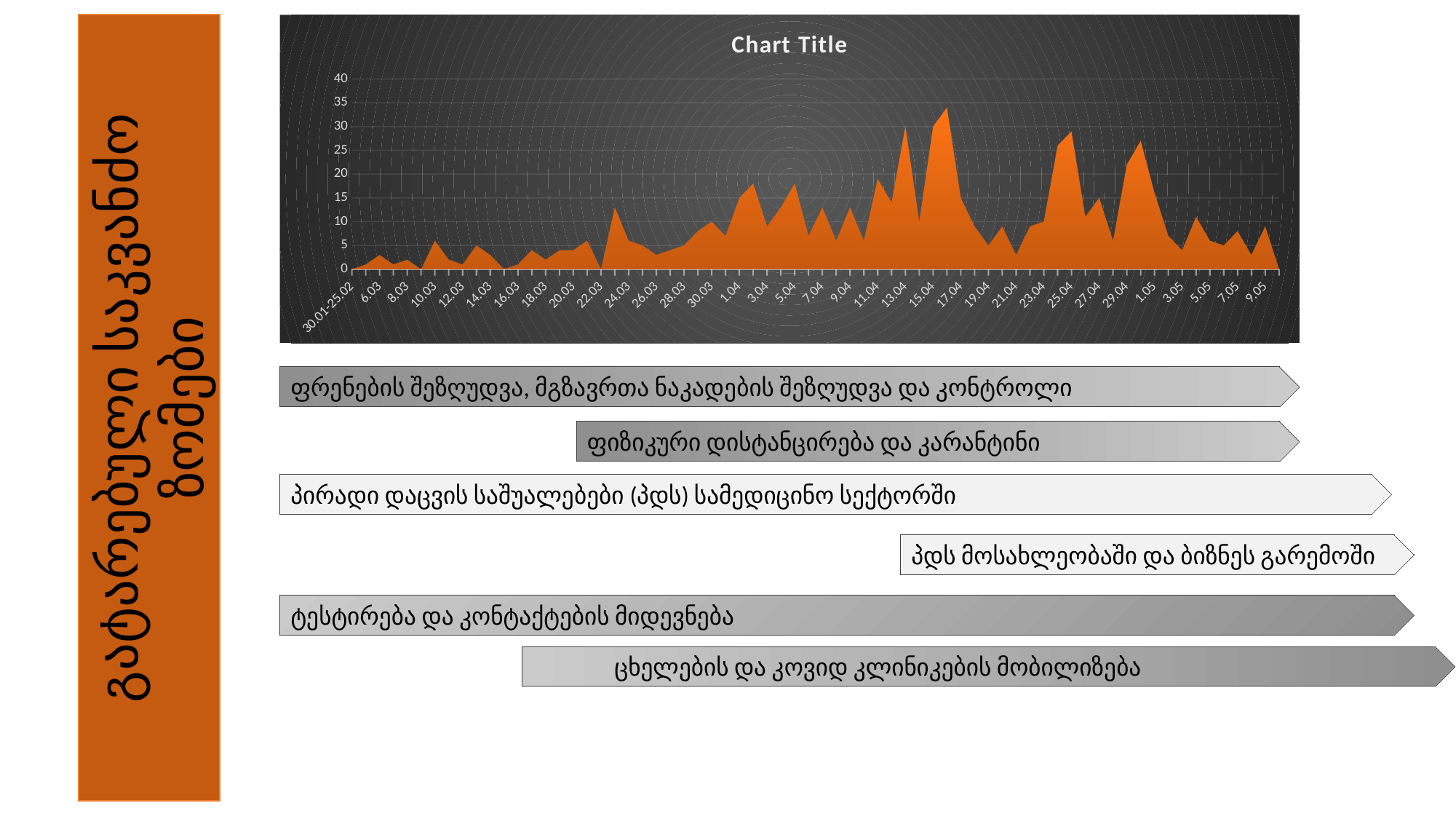
What kind of chart is shown on the slide? area chart What is the title of the chart? Chart Title Is the value for 9.05 greater or less than 15? less Is the value for 25.04 greater or less than 20? greater Is the value for 6.03 greater or less than 10? less What is the first category label on the x axis? 30.01-25.02 Are the values in early March higher or lower than the values in mid-April? lower What is the highest value shown on the chart's vertical axis? 40